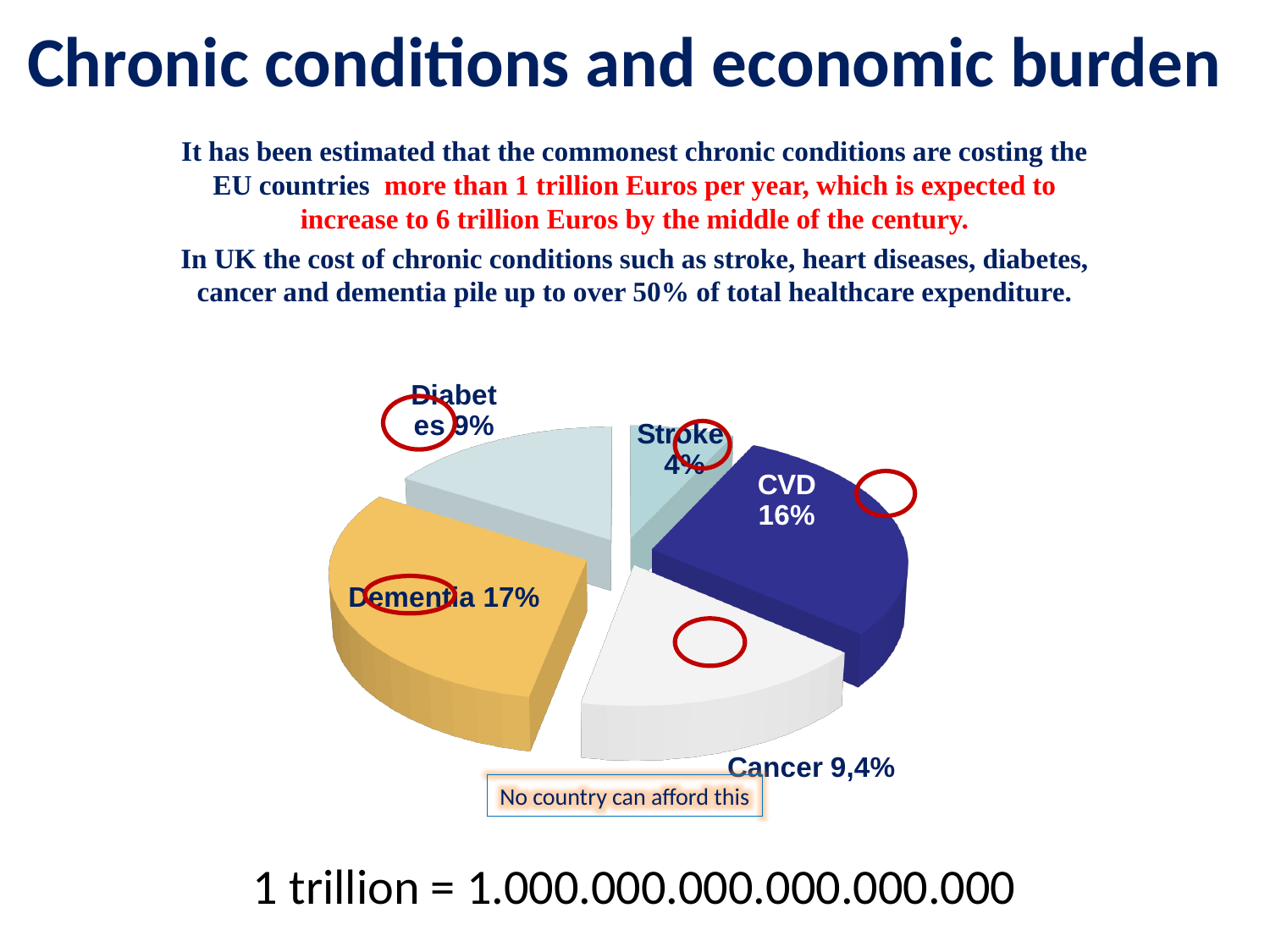
What type of chart is shown on the slide? Pie chart How many slices does the pie chart have? 5 What colour is the CVD slice in the pie chart? Dark blue Which slice is larger, Cancer or Diabetes? Cancer Which condition has the largest slice in the pie chart? Dementia What percentage is shown for Diabetes in the pie chart? 9% What percentage is shown for Dementia in the pie chart? 17% Which condition has the smallest slice in the pie chart? Stroke What percentage is shown for Cancer in the pie chart? 9,4% What percentage is shown for CVD in the pie chart? 16% What is the difference in percentage points between the CVD slice and the Stroke slice? 12 What percentage is shown for Stroke in the pie chart? 4%